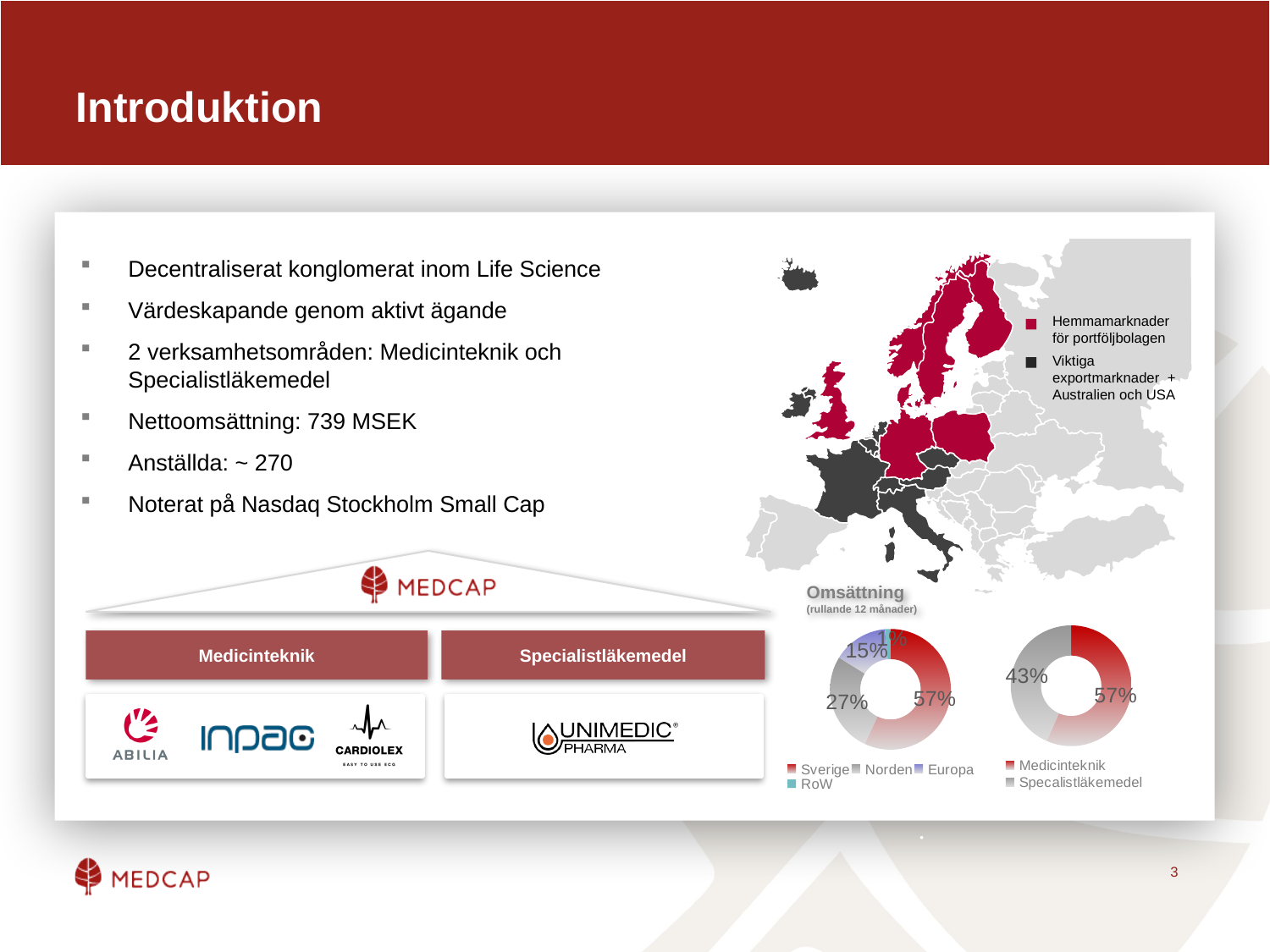
In the right doughnut chart under "Omsättning", what share of revenue comes from Medicinteknik? 57% In the right doughnut chart under "Omsättning", what share of revenue comes from Specialistläkemedel? 43% In the left doughnut chart under "Omsättning", what share of revenue comes from Europa? 15% In the left doughnut chart under "Omsättning", what is the difference in percentage points between Sverige and Norden? 30 What subtitle appears under the chart heading "Omsättning"? (rullande 12 månader) In the right doughnut chart under "Omsättning", which business area has the larger share, Medicinteknik or Specialistläkemedel? Medicinteknik In the left doughnut chart under "Omsättning", what share of revenue comes from Sverige? 57% In the left doughnut chart under "Omsättning", what share of revenue comes from Norden? 27% In the left doughnut chart under "Omsättning", which region has the largest share? Sverige In the left doughnut chart under "Omsättning", which region has the smallest share? RoW In the left doughnut chart under "Omsättning", how many regions does the legend list? 4 What type of charts are shown under the heading "Omsättning"? Doughnut (pie) charts